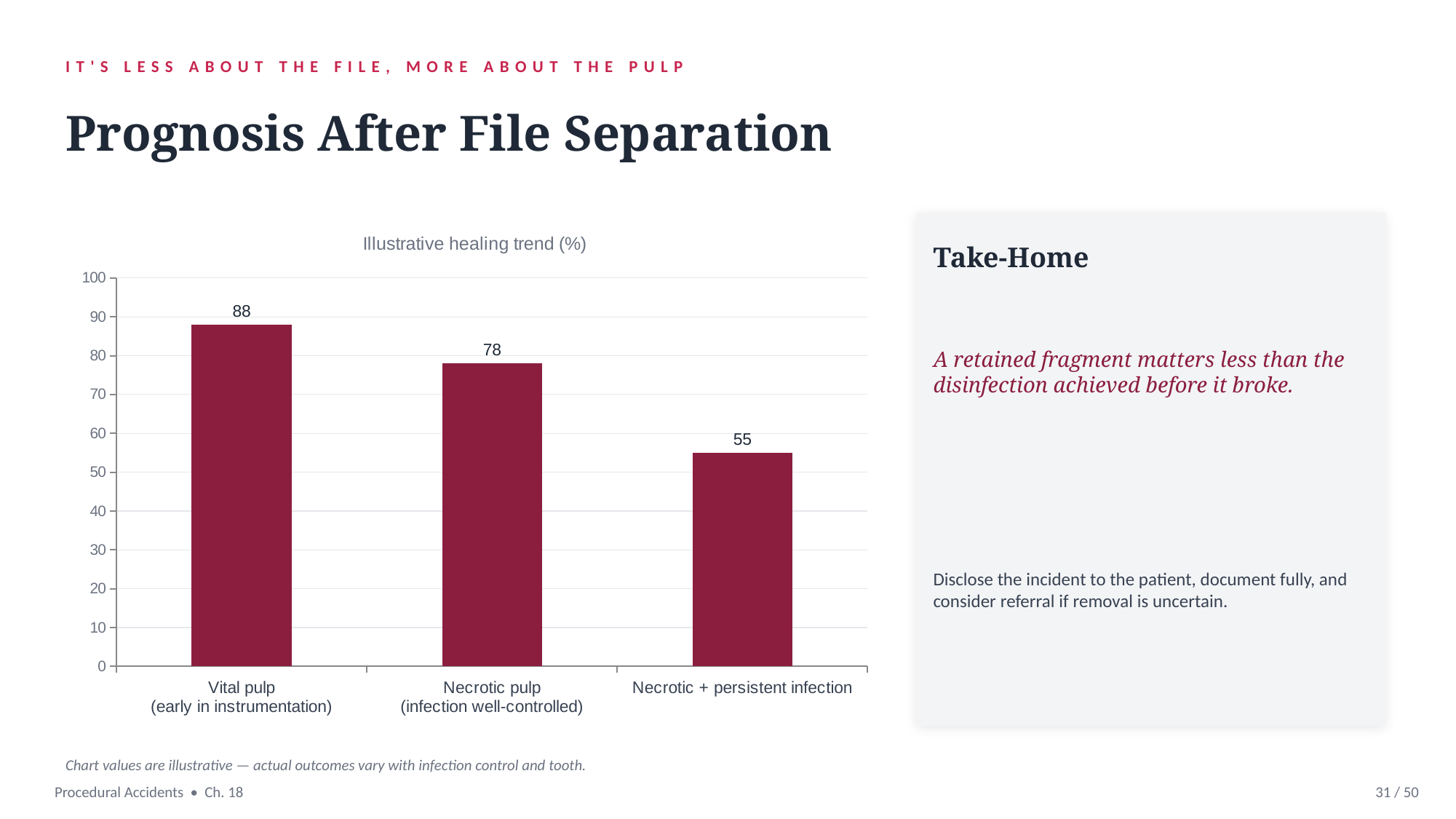
What is the difference between the values for Vital pulp and Necrotic pulp (infection well-controlled)? 10 Is the value for Necrotic + persistent infection greater or less than 60? less What is the value for Necrotic + persistent infection? 55 Which category has the highest value? Vital pulp (early in instrumentation) What is the value for Necrotic pulp (infection well-controlled)? 78 How many categories are shown on the chart? 3 Which is larger, the value for Necrotic pulp (infection well-controlled) or Necrotic + persistent infection? Necrotic pulp (infection well-controlled) What is the title of the chart? Illustrative healing trend (%) What is the value for Vital pulp (early in instrumentation)? 88 What kind of chart is shown on the slide? Bar chart What is the difference between the values for Vital pulp and Necrotic + persistent infection? 33 Which category has the lowest value? Necrotic + persistent infection